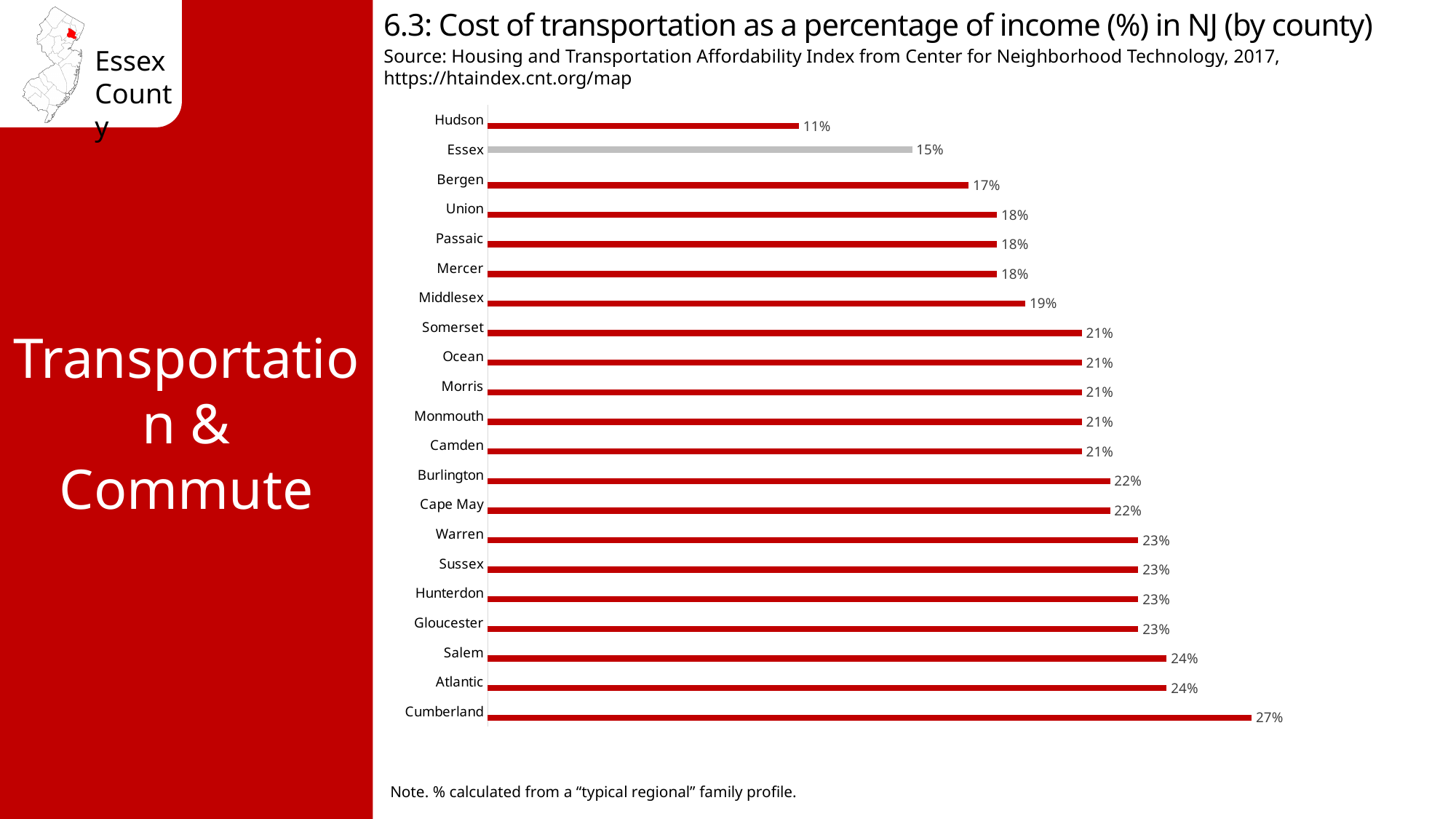
What is the difference in percentage points between Essex and Hudson? 4 How many counties are shown in the chart? 21 What is the value for Atlantic County? 24% What is the cost of transportation as a percentage of income for Essex County? 15% Which county's bar is shown in a different colour (grey) from the others? Essex Which county has a higher cost of transportation as a percentage of income, Bergen or Salem? Salem What kind of chart is shown on the slide? Bar chart What is the cost of transportation as a percentage of income for Hudson County? 11% What is the difference in percentage points between Cumberland and Essex? 12 Which county has the lowest cost of transportation as a percentage of income? Hudson What is the cost of transportation as a percentage of income for Middlesex County? 19% Which county has the highest cost of transportation as a percentage of income? Cumberland